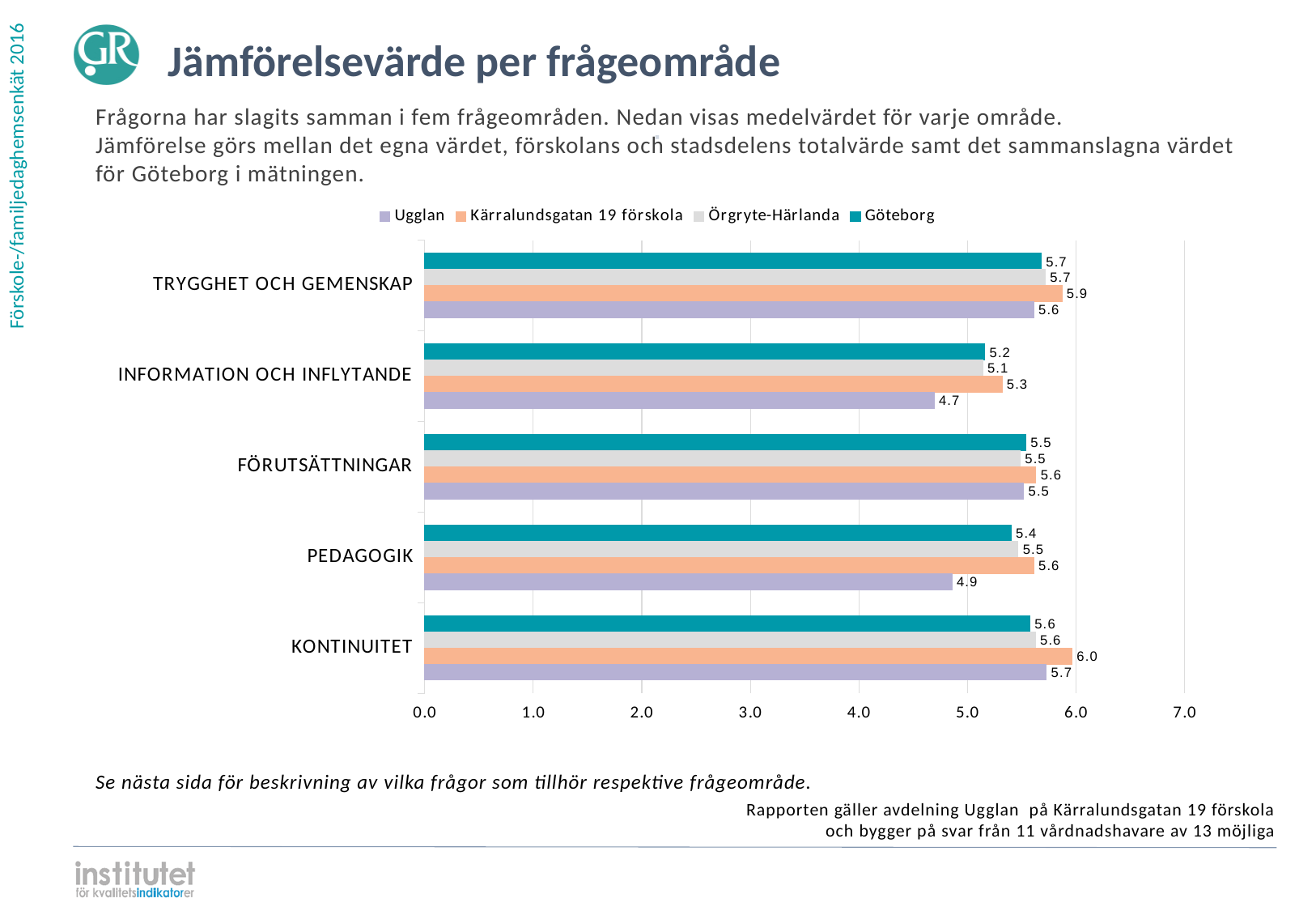
How many categories are shown on the chart? 5 In which category does Ugglan have its lowest value? INFORMATION OCH INFLYTANDE In the KONTINUITET category, which is larger: the value for Ugglan or the value for Göteborg? Ugglan In which category does Kärralundsgatan 19 förskola have its highest value? KONTINUITET What is the value for Ugglan in the INFORMATION OCH INFLYTANDE category? 4.7 What is the difference between the Kärralundsgatan 19 förskola value and the Ugglan value in the PEDAGOGIK category? 0.7 What kind of chart is shown on the slide? Bar chart What is the value for Örgryte-Härlanda in the TRYGGHET OCH GEMENSKAP category? 5.7 Is the value for Ugglan in the PEDAGOGIK category greater or less than 5.0? less What is the value for Kärralundsgatan 19 förskola in the KONTINUITET category? 6.0 How many series does the legend list? 4 What is the value for Göteborg in the PEDAGOGIK category? 5.4